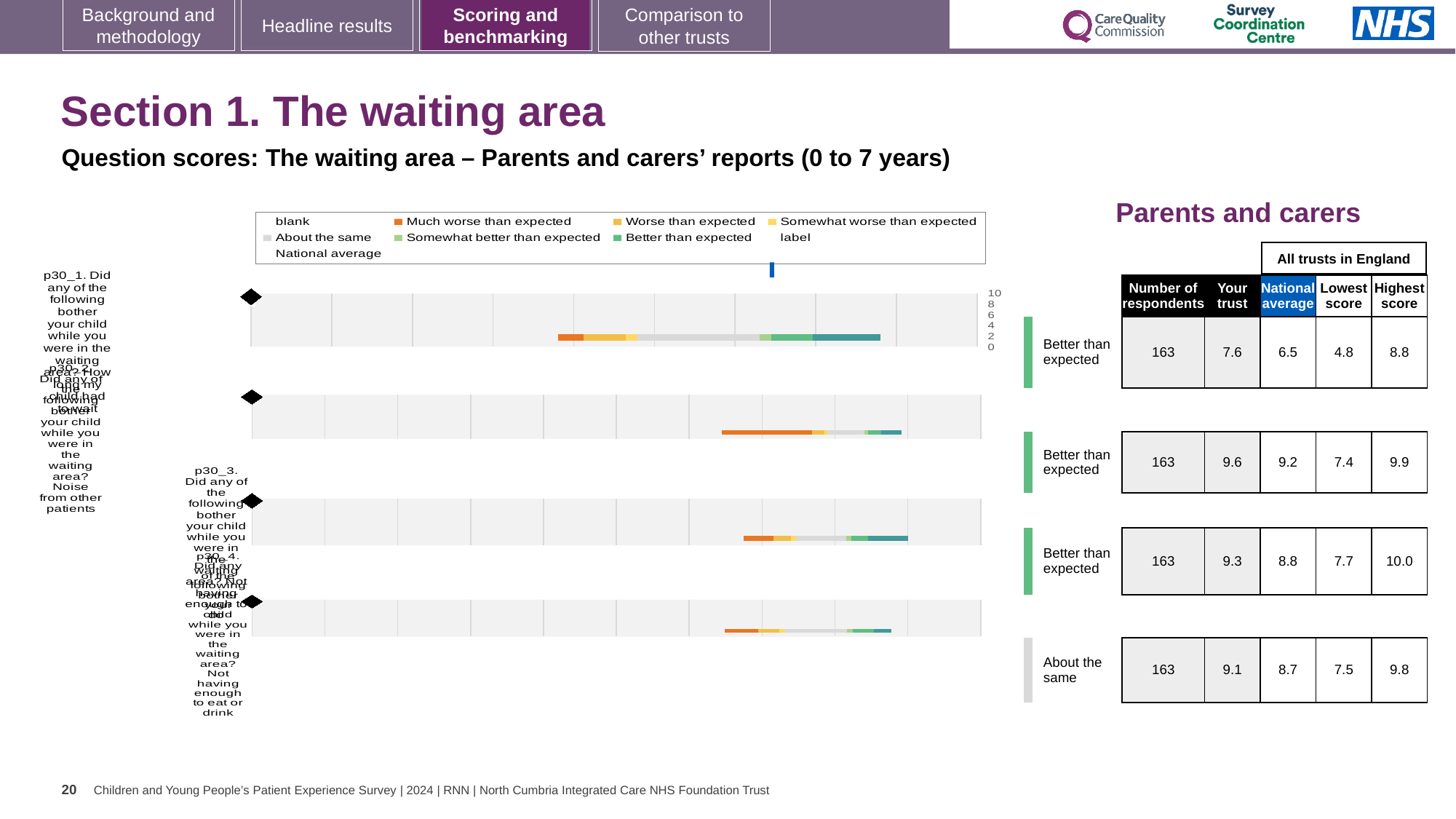
What colour does the legend use for 'Much worse than expected'? orange For the first question row, what is the difference between the 'Your trust' score (7.6) and the national average (6.5)? 1.1 In the table beside the charts, what is the national average for the first question row? 6.5 In the table beside the charts, how many respondents are listed for each question? 163 How many separate bar charts are shown on the slide? 4 In the table beside the charts, what is the 'Your trust' score for the first question row? 7.6 In the table beside the charts, which row has the highest 'Your trust' score? the second row (9.6) What kind of chart is used to show the question scores on this slide? bar chart What colour does the legend use for 'Better than expected'? teal green For the first question row, which is larger: the 'Your trust' score or the national average? Your trust How many entries does the chart legend list? 9 How many of the four question rows are rated 'Better than expected'? 3